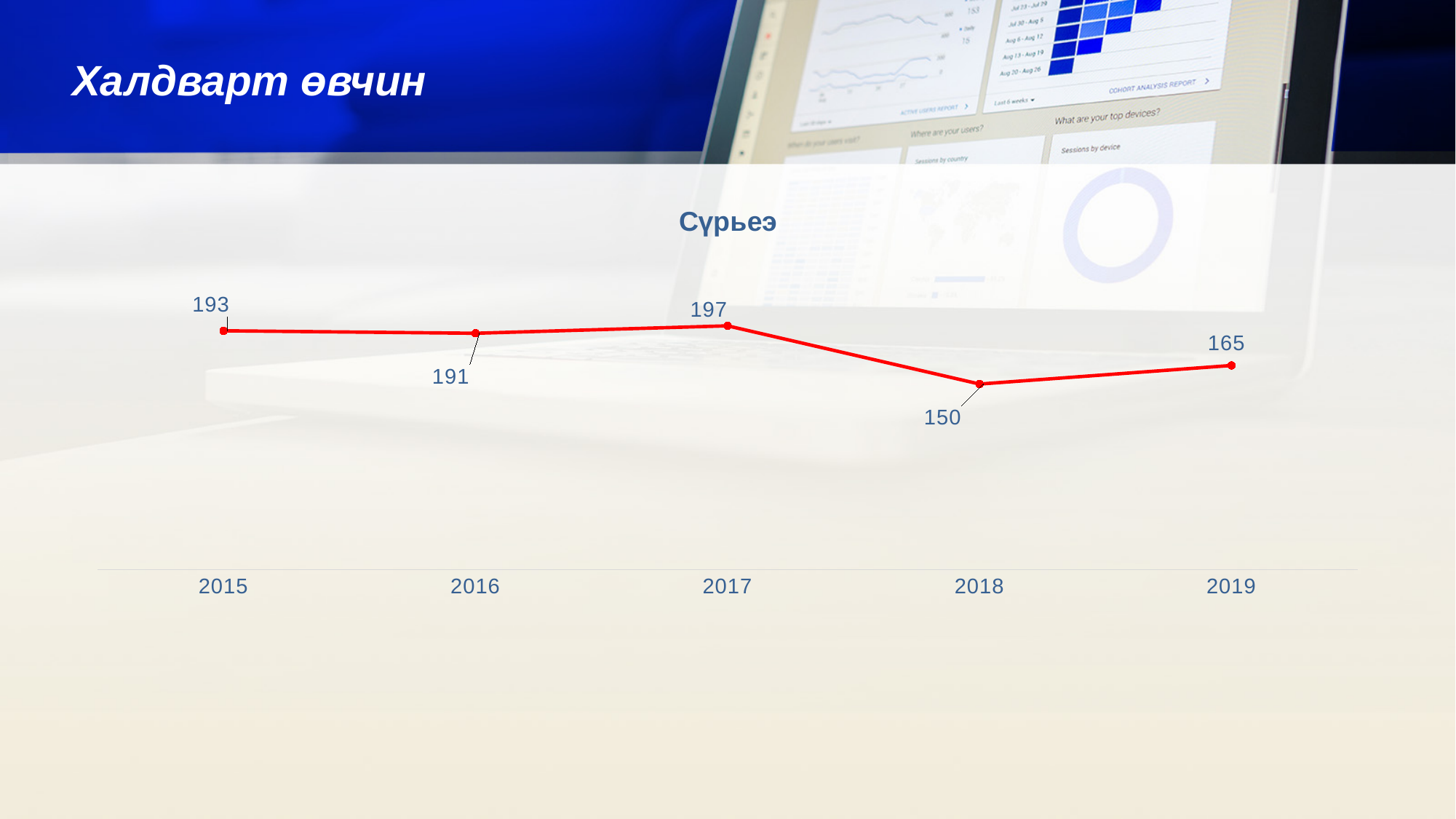
Does the value rise or fall from 2017 to 2018? fall What is the title of the chart? Сүрьеэ How many years are plotted on the chart? 5 What is the difference between the values for 2017 and 2018? 47 Which year has the lowest value? 2018 Which is larger, the value for 2016 or the value for 2019? 2016 What is the value for 2015? 193 What kind of chart is shown? line chart What is the value for 2018? 150 Which year has the highest value? 2017 What is the value for 2019? 165 What is the difference between the values for 2015 and 2016? 2